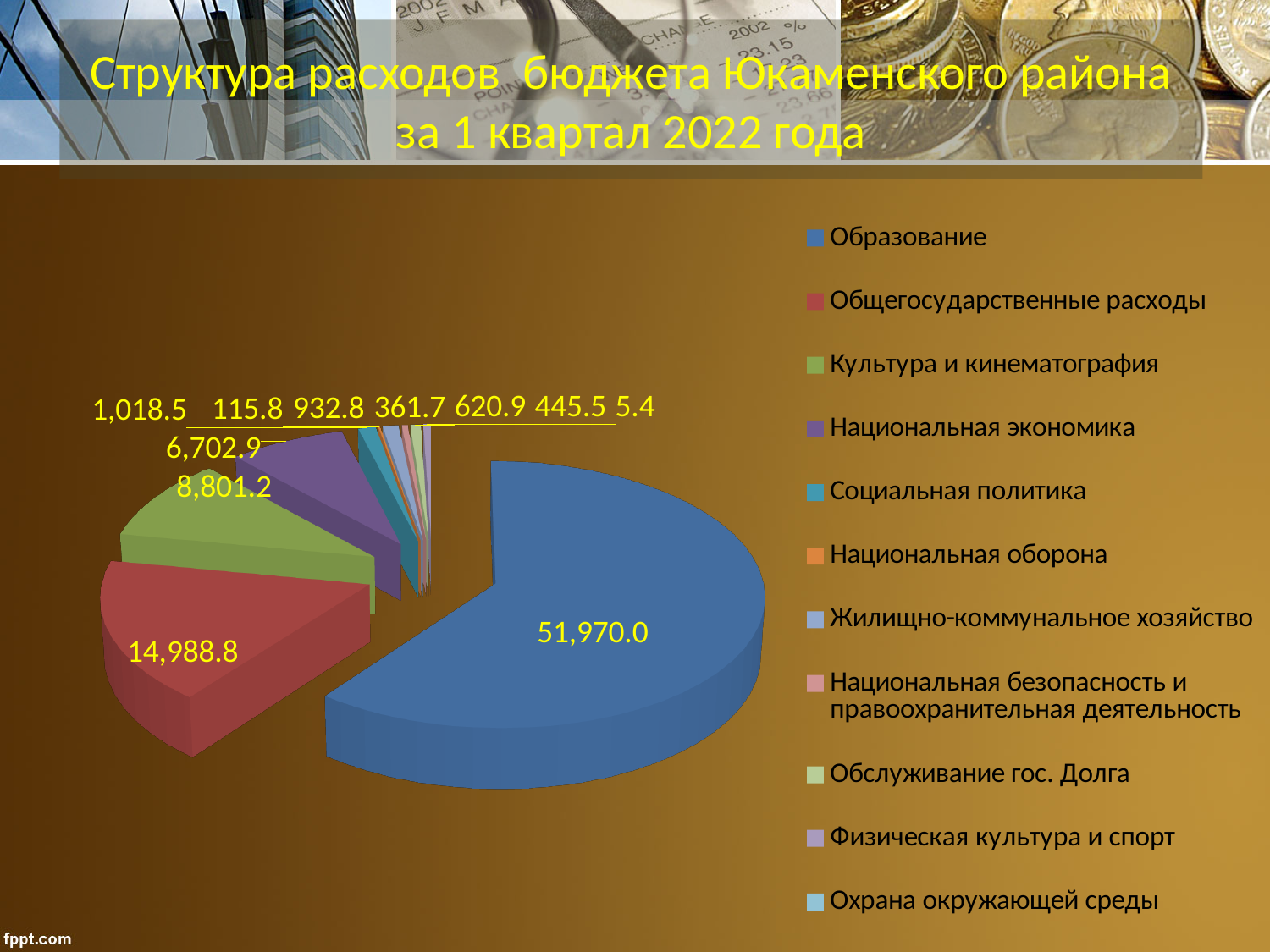
What is the smallest value printed on the chart? 5.4 What is the value for Образование? 51,970.0 What is the difference between the values for Образование and Общегосударственные расходы? 36,981.2 What is the value for Национальная экономика? 6,702.9 What is the difference between the values for Культура и кинематография and Национальная экономика? 2,098.3 Which is larger, the value for Общегосударственные расходы or the value for Культура и кинематография? Общегосударственные расходы What is the value for Культура и кинематография? 8,801.2 What is the title of the chart on the slide? Структура расходов бюджета Юкаменского района за 1 квартал 2022 года How many categories does the legend list? 11 What kind of chart is shown on the slide? pie chart What is the value for Общегосударственные расходы? 14,988.8 Which category has the largest slice of the pie? Образование